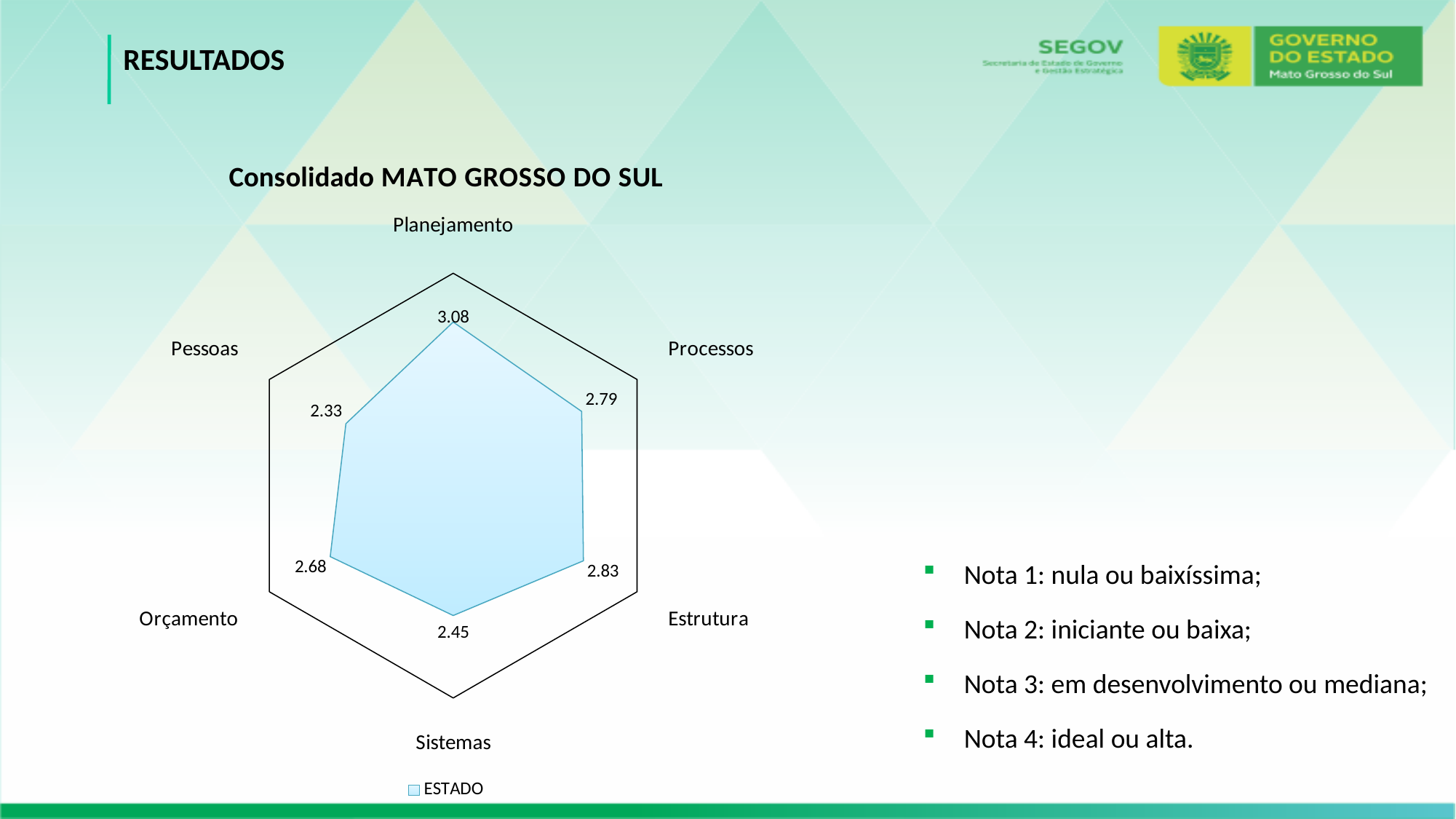
Which category has the lowest value? Pessoas What is the value for Pessoas? 2.33 What is the difference between the values for Planejamento and Pessoas? 0.75 What kind of chart is shown on the slide? Radar chart What is the title of the chart? Consolidado MATO GROSSO DO SUL What is the value for Estrutura? 2.83 How many series does the legend list? 1 Which category has the highest value? Planejamento How many categories are plotted on the chart? 6 What is the value for Planejamento? 3.08 Which is larger, the value for Processos or the value for Orçamento? Processos What is the value for Sistemas? 2.45